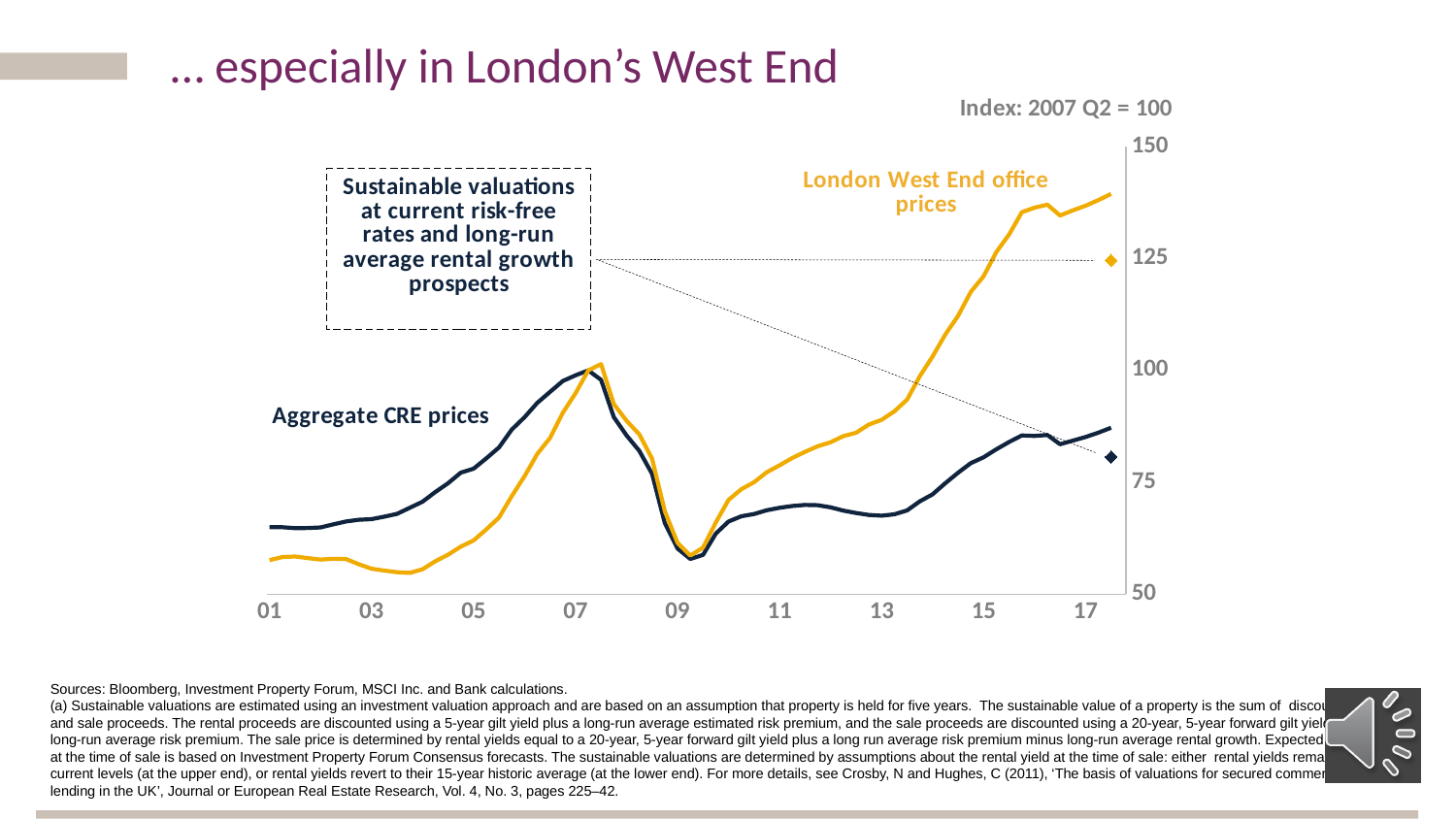
What kind of chart is shown on the slide? Line chart Is the value of London West End office prices at 17 greater or less than 125? greater Is the value of London West End office prices at 01 greater or less than 75? less At 01, which series has the higher value: London West End office prices or Aggregate CRE prices? Aggregate CRE prices Which colour is the London West End office prices line? Yellow What is the base period of the index used on the chart? 2007 Q2 = 100 Is the value of Aggregate CRE prices at 09 greater or less than 75? less At 17, which series has the higher value: London West End office prices or Aggregate CRE prices? London West End office prices How many year labels are shown on the x axis? 9 Do London West End office prices rise or fall between 13 and 17? Rise